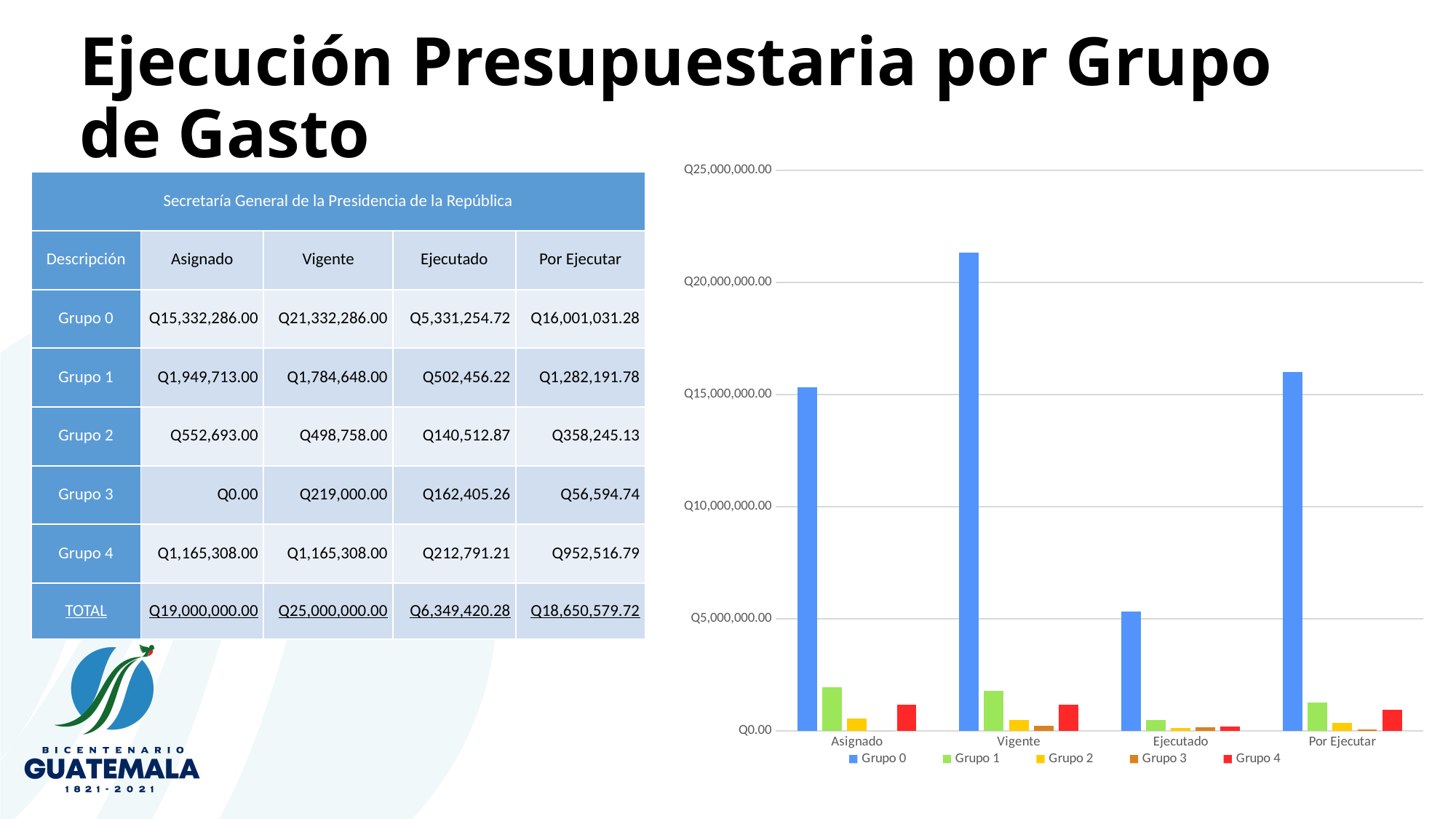
What is the difference between the Grupo 0 values for Vigente and Asignado? Q6,000,000.00 Is the Grupo 0 value for Por Ejecutar greater or less than Q15,000,000.00? greater What kind of chart is shown on the slide? bar chart In which category is the Grupo 0 bar the highest? Vigente How many categories are shown along the x axis of the chart? 4 What is the Grupo 3 value for Asignado? Q0.00 In the Asignado category, which is larger, Grupo 1 or Grupo 4? Grupo 1 Is the Grupo 0 value for Vigente greater or less than Q20,000,000.00? greater What is the Grupo 0 value for Vigente? Q21,332,286.00 What colour represents Grupo 0 in the chart legend? blue In which category is the Grupo 0 bar the lowest? Ejecutado How many series does the chart legend list? 5